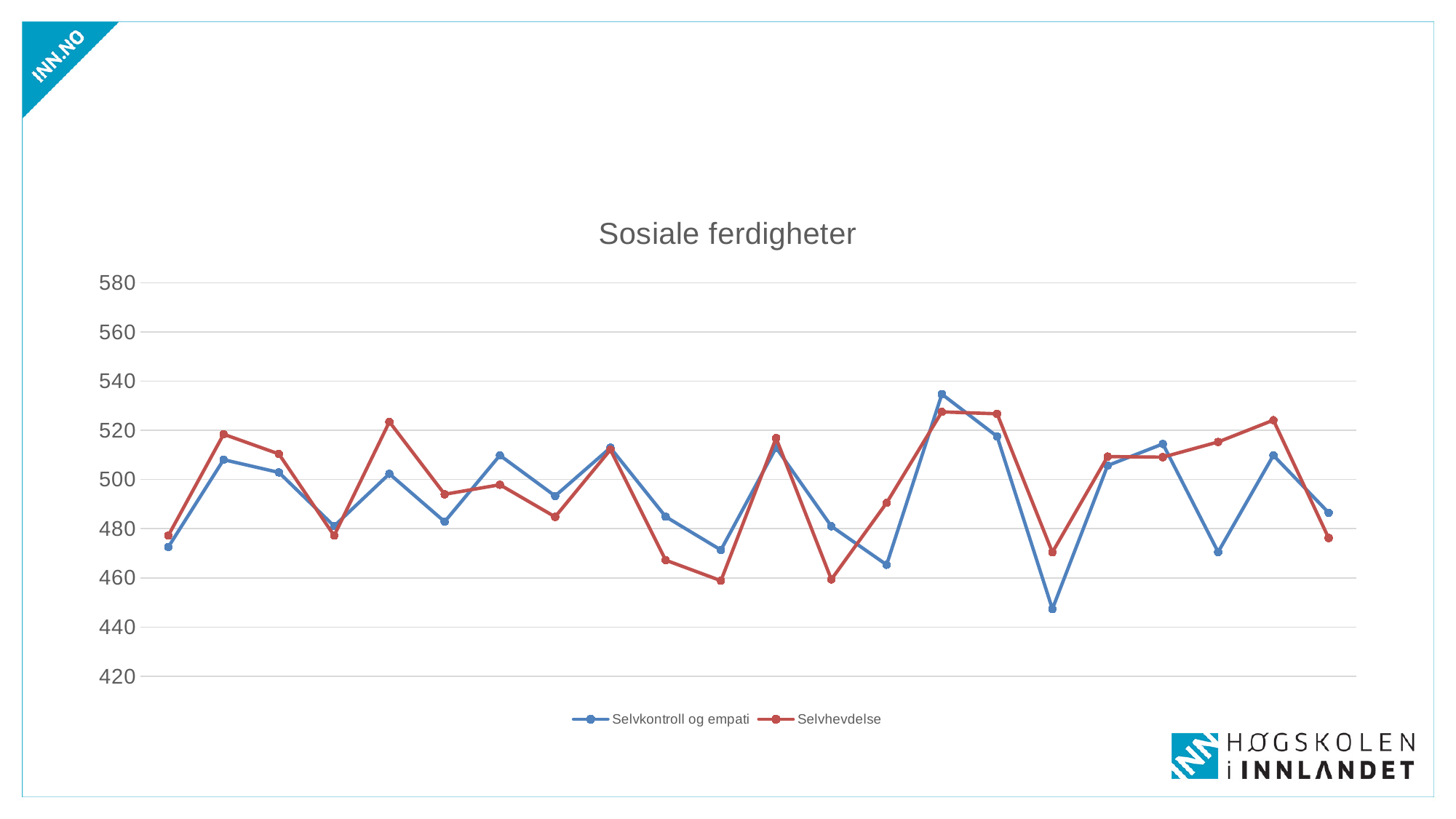
Which series is drawn in red? Selvhevdelse How many series does the legend list? 2 How many data points does each line have? 22 Is the lowest value of the Selvkontroll og empati line greater or less than 460? less At the second data point, which series has the higher value? Selvhevdelse Which series reaches the lowest value anywhere on the chart? Selvkontroll og empati What kind of chart is shown on the slide? line chart Does the Selvkontroll og empati line rise or fall from the first point to the second point? rise Is the highest value of the Selvkontroll og empati line greater or less than 520? greater Is the lowest value of the Selvhevdelse line greater or less than 480? less What is the title of the chart? Sosiale ferdigheter